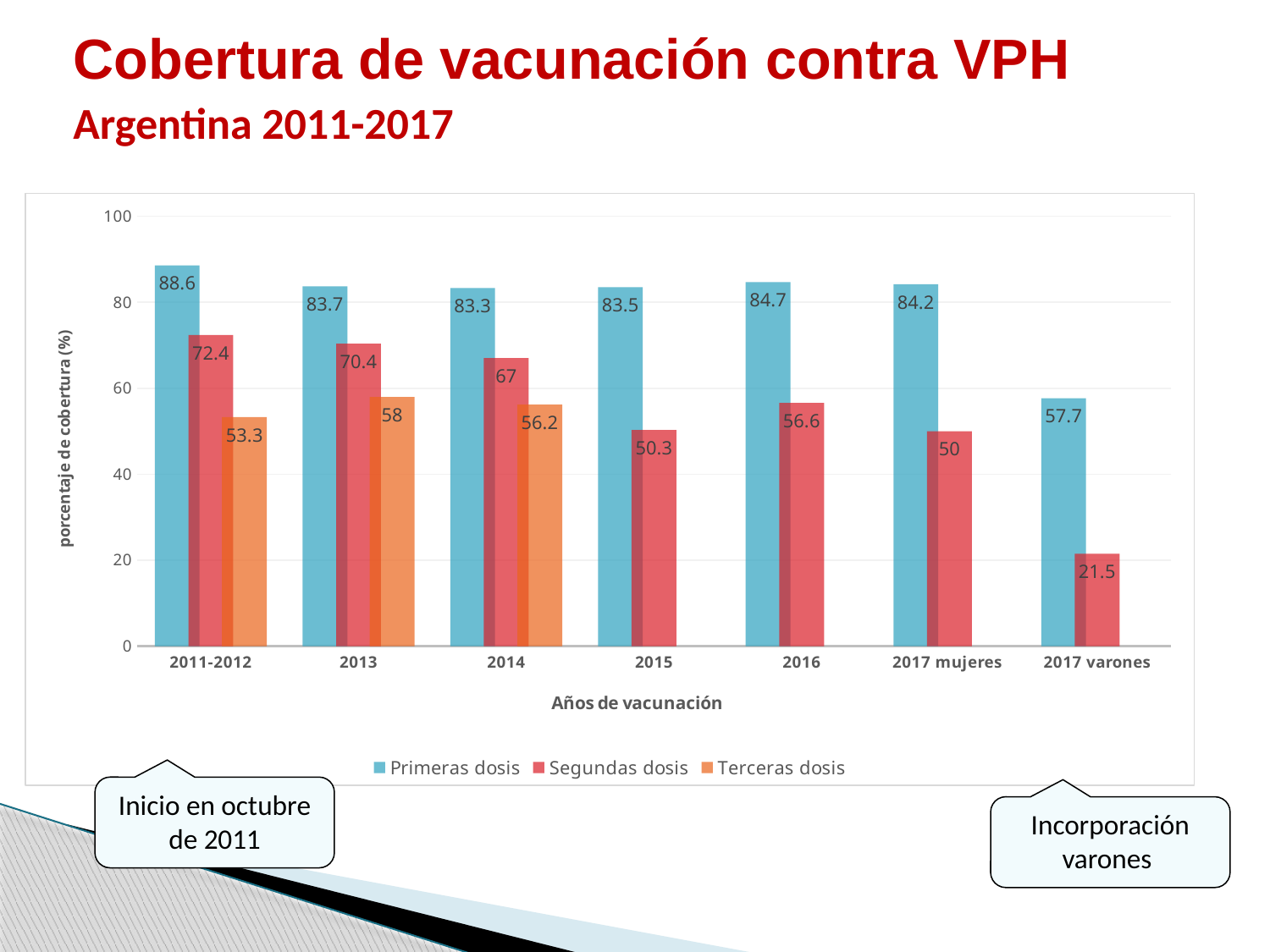
How many series does the legend list? 3 What is the value of Primeras dosis for 2011-2012? 88.6 Which category has the highest Primeras dosis value? 2011-2012 What is the value of Segundas dosis for 2017 varones? 21.5 What kind of chart is shown on the slide? bar chart Is the value of Primeras dosis for 2017 varones greater or less than 60? less How many categories are shown on the x axis? 7 Which category has the lowest Segundas dosis value? 2017 varones What is the difference between Primeras dosis and Segundas dosis for 2017 mujeres? 34.2 What is the value of Terceras dosis for 2013? 58 What is the label of the y axis? porcentaje de cobertura (%) Which is larger, Segundas dosis for 2013 or Segundas dosis for 2014? Segundas dosis for 2013